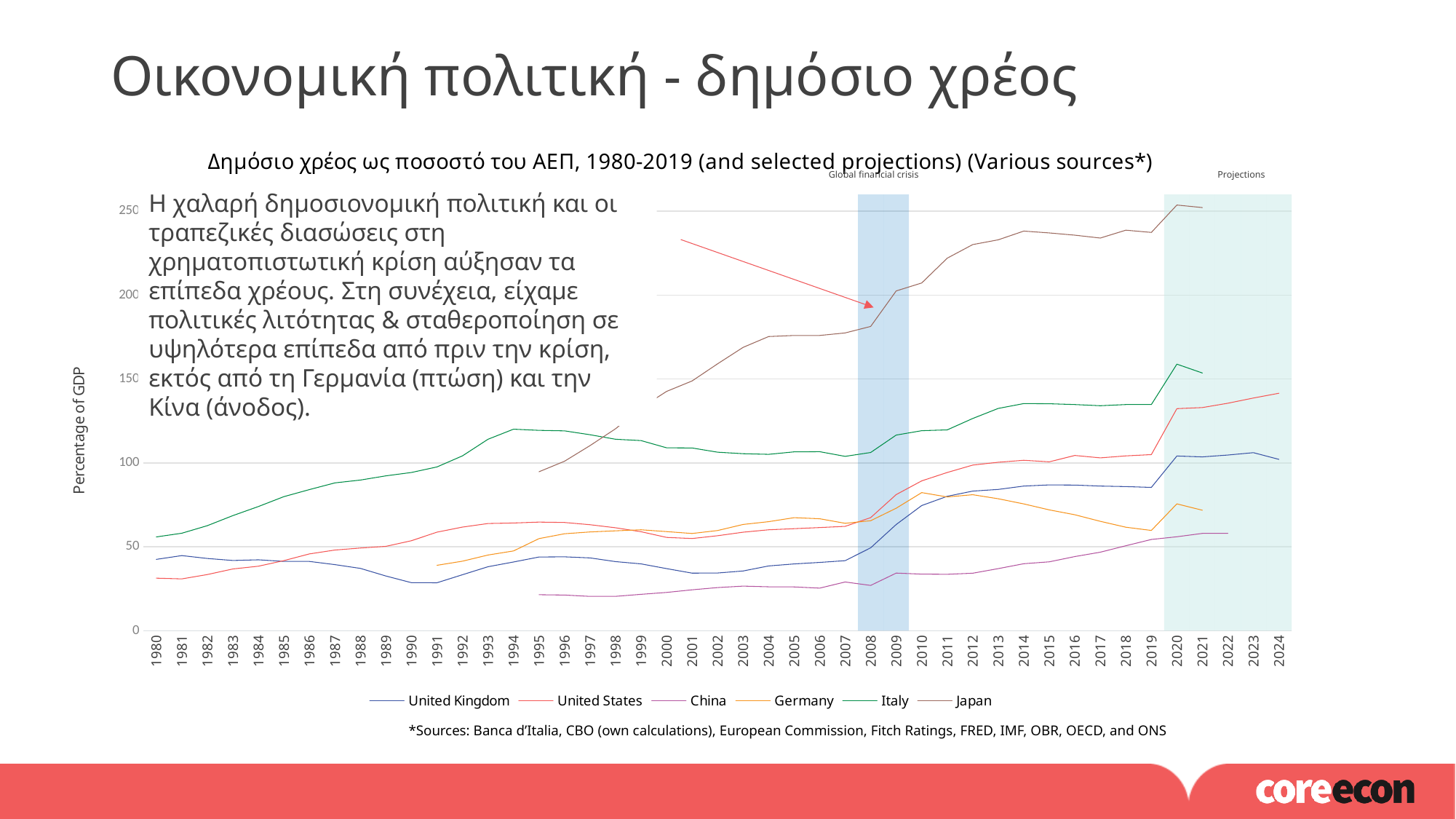
What is the label on the vertical axis of the chart? Percentage of GDP How many series does the legend list? 6 What kind of chart is shown on the slide? line chart Which country has the highest public debt as a percentage of GDP in 2020? Japan In 2024, which is higher: the United States or the United Kingdom? United States Is the value for China in 2000 greater or less than 50? less Is the value for Italy in 2019 greater or less than 100? greater In 2010, which is higher: Italy or the United Kingdom? Italy Does the value for China rise or fall between 2000 and 2022? rise Does the value for Germany rise or fall between 2010 and 2019? fall Which country has the lowest value in 1980? United States Is the value for Japan in 2020 greater or less than 200? greater